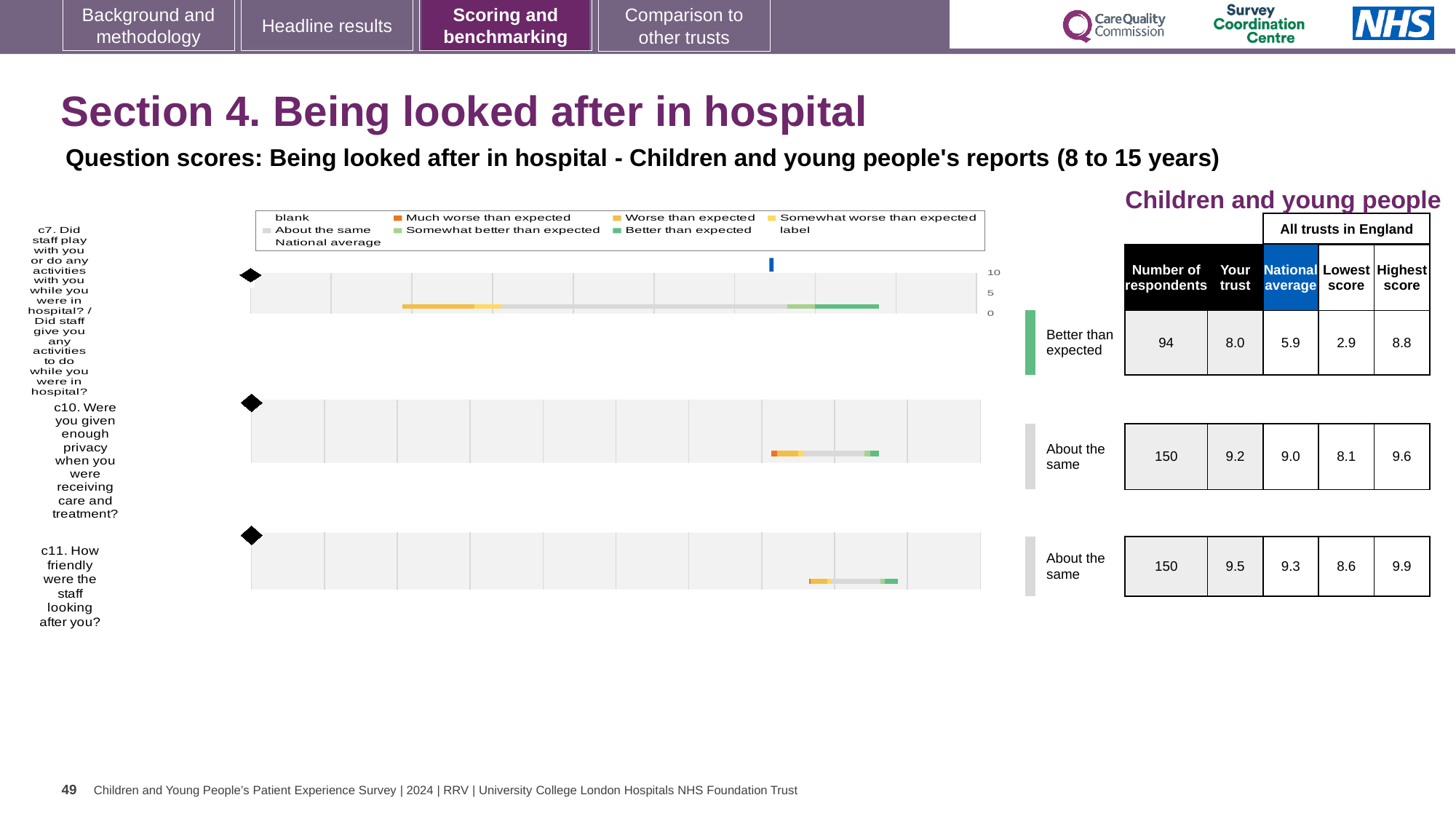
For question c10, which is larger: the 'Your trust' score or the national average? Your trust Which question has the highest 'Your trust' score? c11. How friendly were the staff looking after you? How many respondents answered question c11 (How friendly were the staff looking after you?)? 150 What is the lowest score among all trusts in England for question c10? 8.1 What is the difference between the 'Your trust' score and the national average for question c7? 2.1 What kind of chart is used to show the question scores on this slide? bar chart What benchmark category is shown for question c7? Better than expected How many questions are plotted in the chart on this slide? 3 Which question has the lowest 'Your trust' score? c7. Did staff play with you or do any activities with you while you were in hospital? What is the national average score for question c10 (Were you given enough privacy when you were receiving care and treatment?)? 9.0 What is the 'Your trust' score for question c7 (Did staff play with you or do any activities with you while you were in hospital?)? 8.0 What is the highest score among all trusts in England for question c11? 9.9